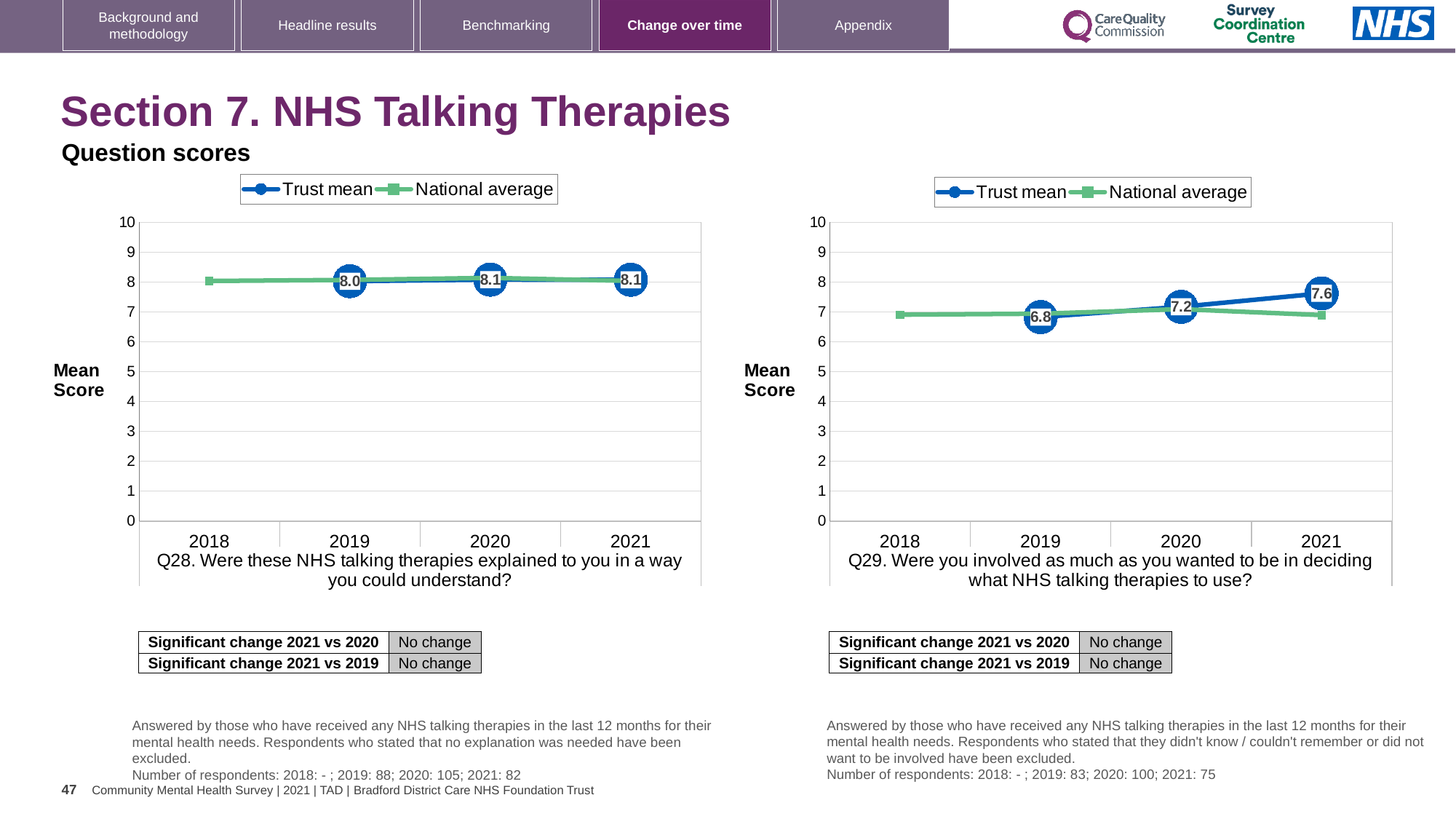
In the Q28 chart, what is the Trust mean for 2021? 8.1 In the Q29 chart, which year has the highest Trust mean? 2021 How many series does the legend of the Q28 chart list? 2 In the Q28 chart, is the National average for 2018 greater or less than 9? less In the Q29 chart, is the Trust mean for 2020 greater or less than 7? greater In the Q29 chart, which year has the lowest Trust mean? 2019 In the Q29 chart, what is the Trust mean for 2019? 6.8 In the Q29 chart, what is the Trust mean for 2021? 7.6 In the Q29 chart, what is the difference between the Trust mean in 2021 and in 2019? 0.8 In the Q28 chart, what is the Trust mean for 2019? 8.0 What type of chart is the Q29 chart? line chart In the Q29 chart, does the Trust mean rise or fall from 2019 to 2021? rise